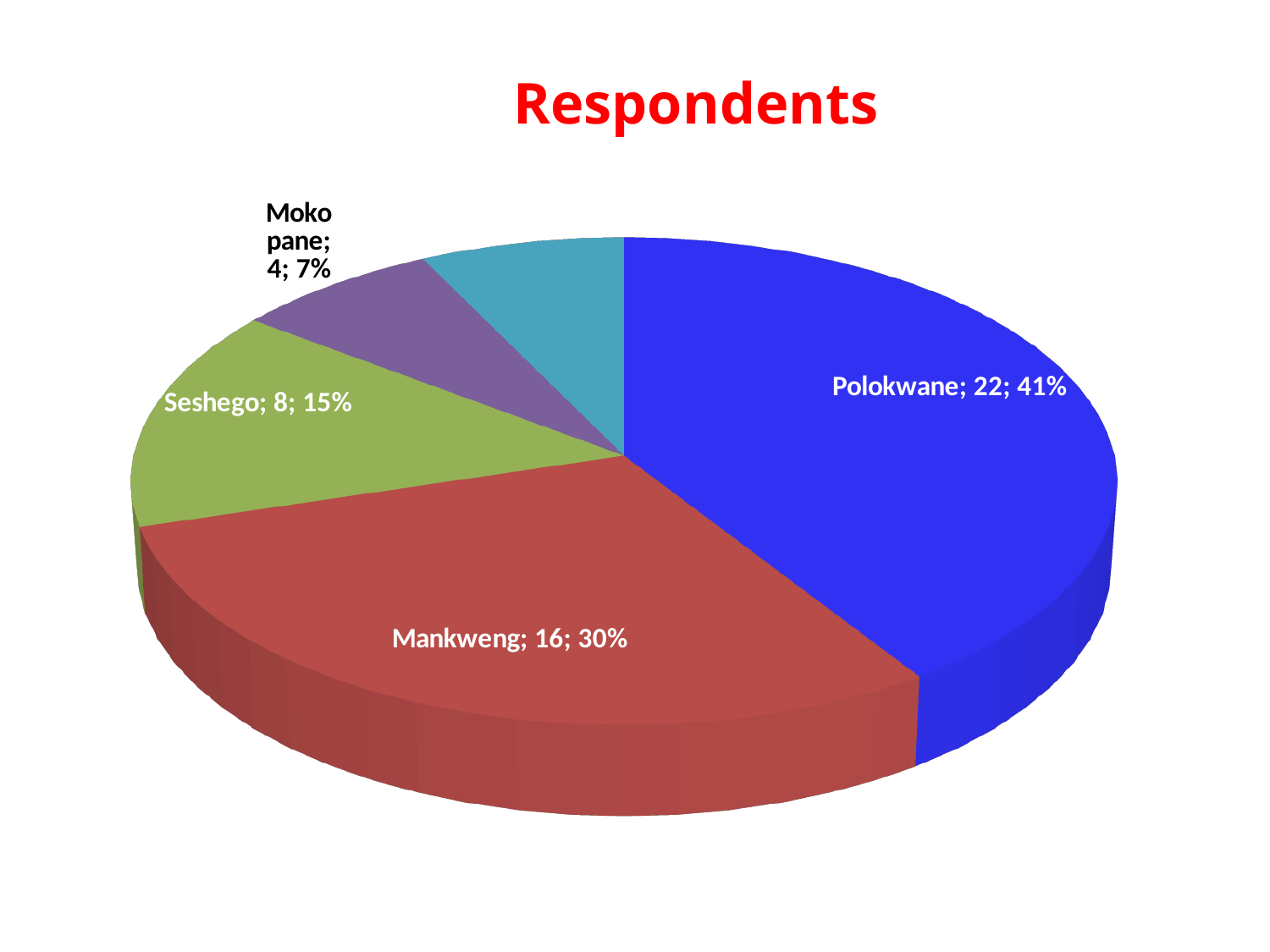
What is the title of the chart? Respondents How many respondents are from Mankweng? 16 How many respondents are from Mokopane? 4 How many slices does the pie chart have? 5 Which area has the highest number of respondents? Polokwane Which has more respondents, Mankweng or Seshego? Mankweng How many respondents are from Polokwane? 22 How many respondents are from Seshego? 8 What share of respondents does the Polokwane slice represent? 41% What share of respondents does the Seshego slice represent? 15% What kind of chart is shown on the slide? pie chart What is the difference in respondents between Polokwane and Mankweng? 6